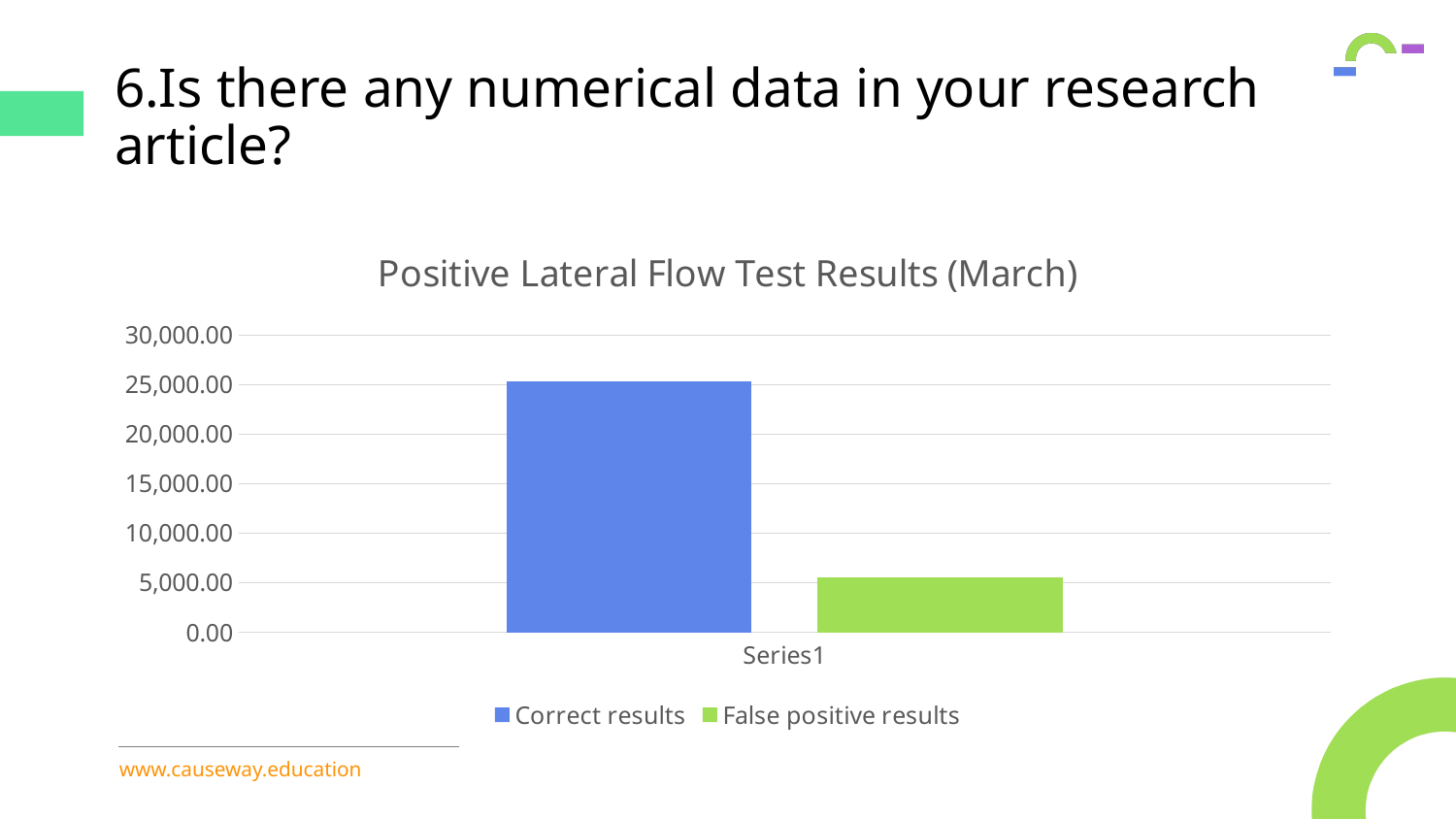
What kind of chart is shown on the slide? bar chart Is the value for Correct results greater or less than 30,000.00? less Is the value for False positive results greater or less than 10,000.00? less Is the value for Correct results greater or less than 20,000.00? greater What is the category label shown on the x axis? Series1 How many bars are plotted in the chart? 2 How many series does the legend list? 2 Which series has the higher value, Correct results or False positive results? Correct results What is the title of the chart? Positive Lateral Flow Test Results (March) Which series has the lowest value? False positive results